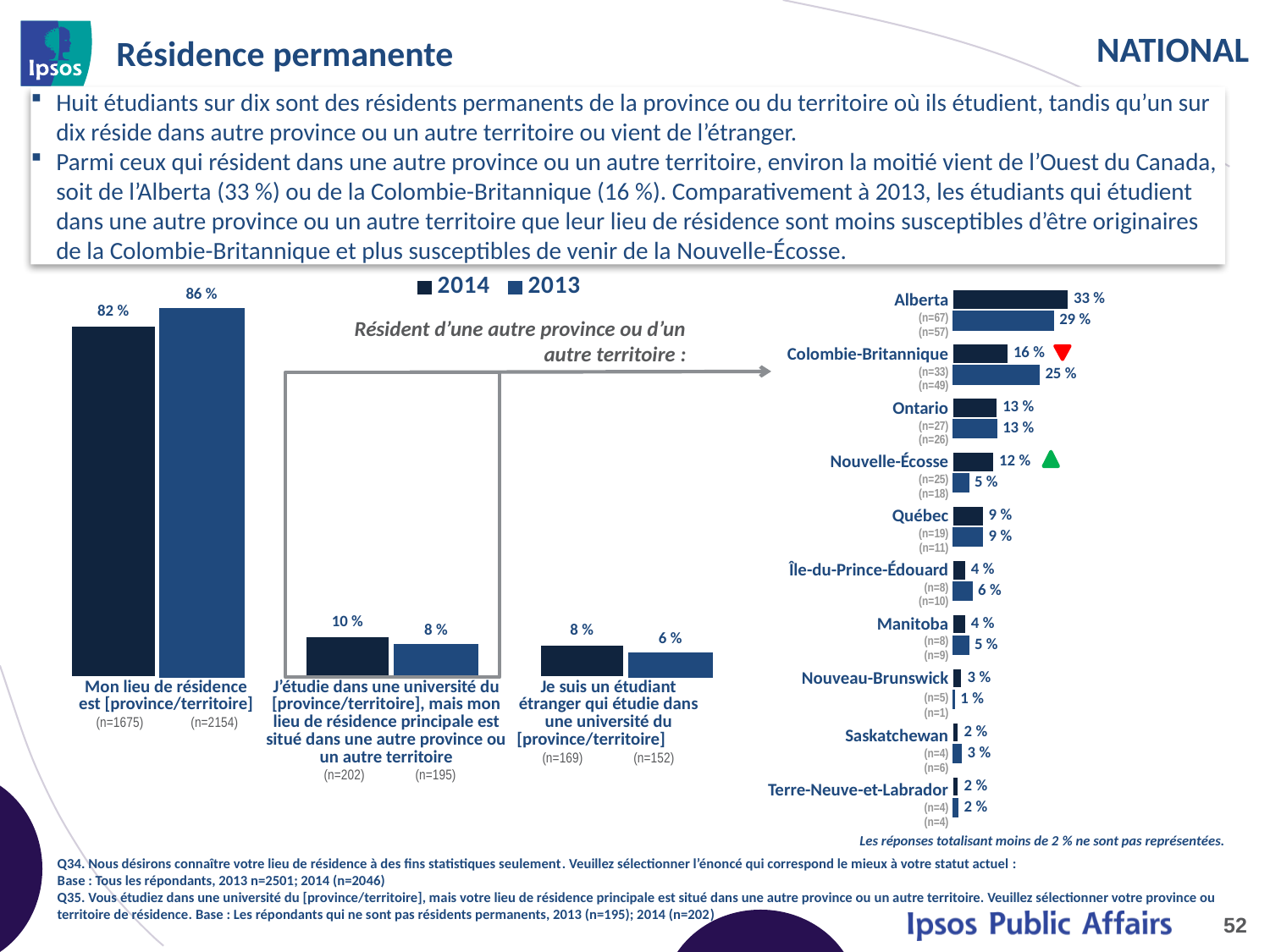
In the right chart (provinces/territories), which province has the highest 2014 value? Alberta In the left bar chart, what is the 2013 value for "Je suis un étudiant étranger qui étudie dans une université du [province/territoire]"? 6 % In the right chart (provinces/territories), how many provinces or territories are listed? 10 In the left bar chart, how many categories are shown on the x axis? 3 In the left bar chart, what is the difference between the 2013 and 2014 values for "Mon lieu de résidence est [province/territoire]"? 4 % In the right chart (provinces/territories), what is the 2013 value for Colombie-Britannique? 25 % In the right chart (provinces/territories), which is larger for Colombie-Britannique: the 2014 value or the 2013 value? 2013 What kind of chart is the right chart showing provinces and territories? Bar chart In the left bar chart, what is the 2014 value for "Mon lieu de résidence est [province/territoire]"? 82 % In the right chart (provinces/territories), what is the 2014 value for Alberta? 33 % How many series does the legend at the top of the charts list? 2 In the right chart (provinces/territories), what is the difference between the 2014 and 2013 values for Nouvelle-Écosse? 7 %